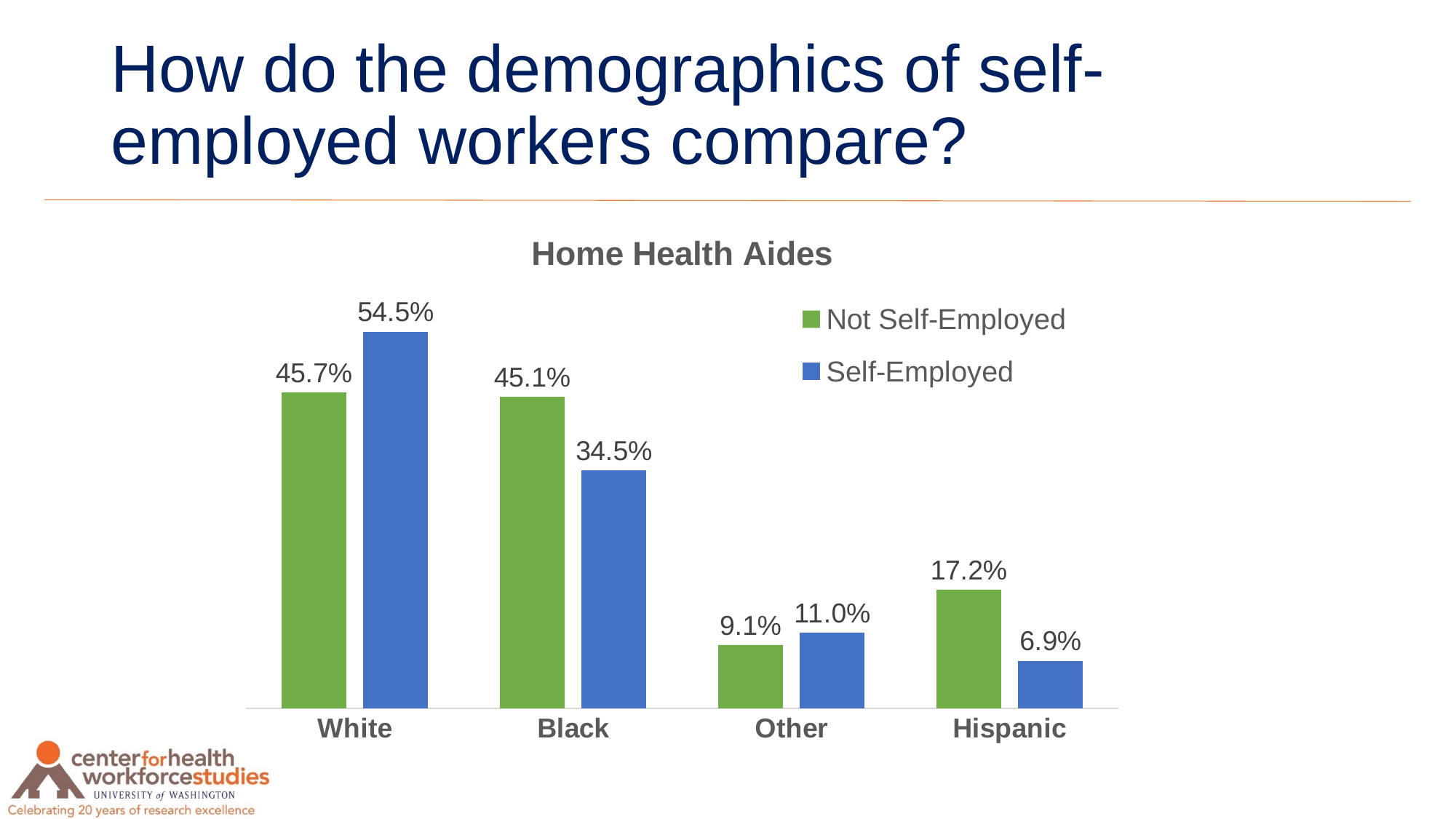
How many categories are shown on the x axis? 4 What is the Self-Employed value for White? 54.5% What is the title of the chart? Home Health Aides Which category has the lowest Not Self-Employed value? Other What is the Not Self-Employed value for Black? 45.1% What is the difference between the Not Self-Employed and Self-Employed values for Black? 10.6% What is the Not Self-Employed value for Other? 9.1% Which is larger for Other: the Not Self-Employed value or the Self-Employed value? Self-Employed What kind of chart is shown? Bar chart What is the Self-Employed value for Hispanic? 6.9% How many series does the legend list? 2 Which category has the highest Self-Employed value? White